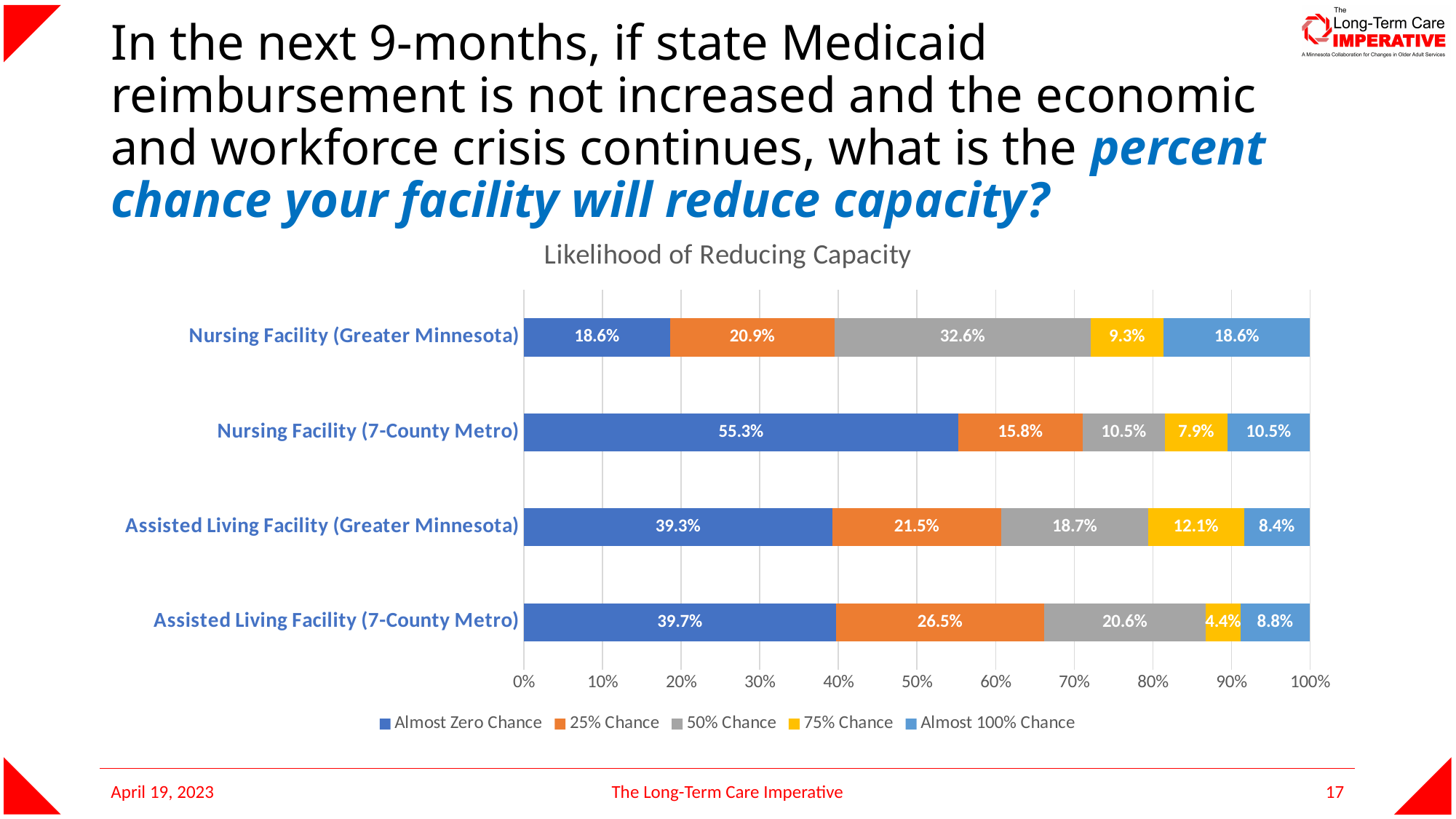
What is the total of the stacked bar for Nursing Facility (Greater Minnesota)? 100.0% How many facility categories are shown in the chart? 4 What kind of chart is shown on the slide? Stacked bar chart Which category has the lowest value for 75% Chance? Assisted Living Facility (7-County Metro) What is the value for Almost Zero Chance for Nursing Facility (7-County Metro)? 55.3% What is the title of the chart? Likelihood of Reducing Capacity Which has the larger 50% Chance value: Assisted Living Facility (Greater Minnesota) or Assisted Living Facility (7-County Metro)? Assisted Living Facility (7-County Metro) Which category has the highest value for Almost Zero Chance? Nursing Facility (7-County Metro) How many series does the legend list? 5 What is the value for 25% Chance for Assisted Living Facility (7-County Metro)? 26.5% What is the value for 50% Chance for Nursing Facility (Greater Minnesota)? 32.6% What is the difference between the Almost 100% Chance values for Nursing Facility (Greater Minnesota) and Nursing Facility (7-County Metro)? 8.1 percentage points